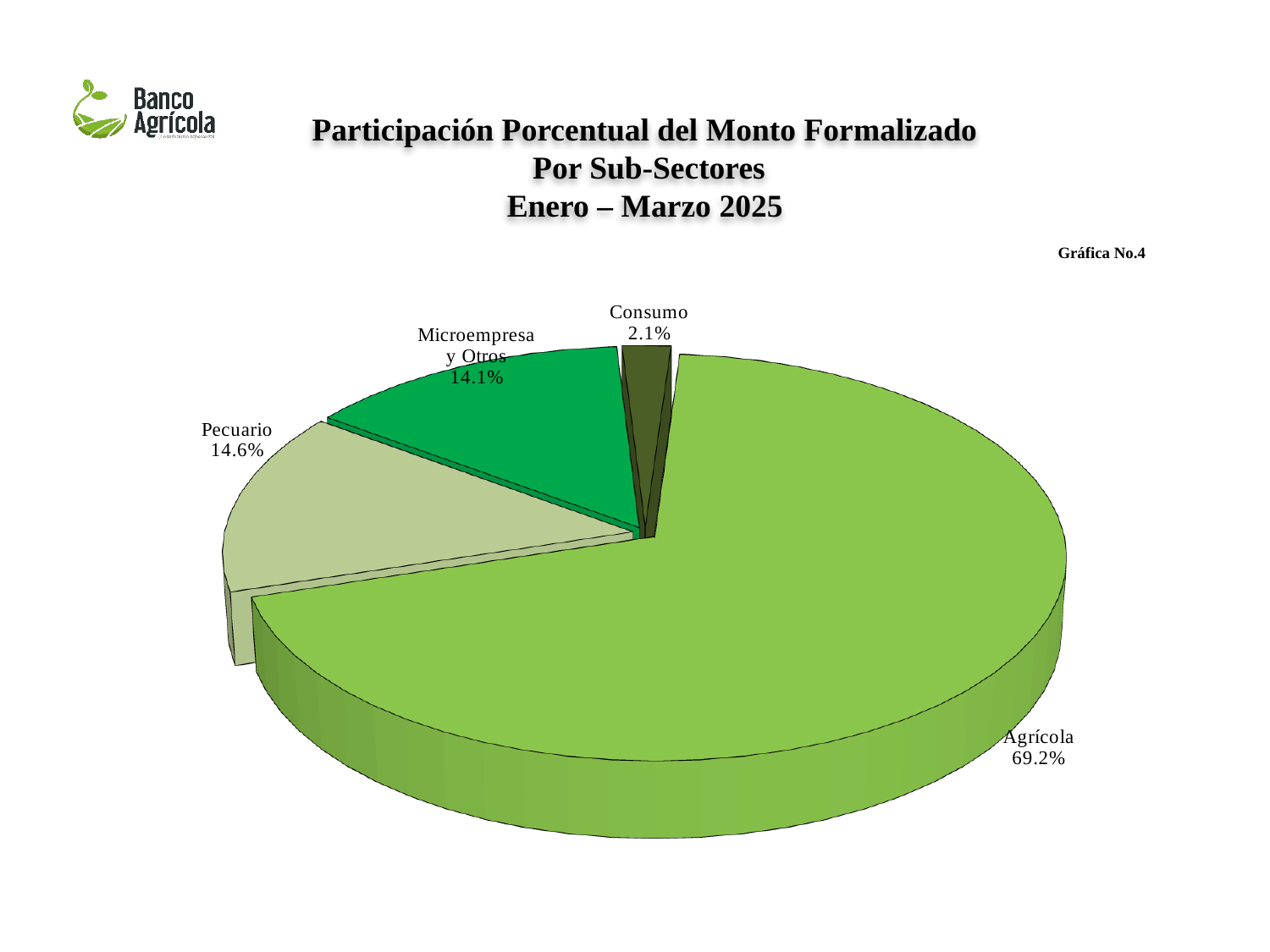
What kind of chart is shown on the slide? Pie chart What share of the pie does Consumo hold? 2.1% What is the difference in percentage points between the Pecuario and Microempresa y Otros shares? 0.5 How many sub-sectors (slices) are shown in the pie chart? 4 What share of the pie does Microempresa y Otros hold? 14.1% What share of the pie does Pecuario hold? 14.6% What period does the chart title say the data covers? Enero – Marzo 2025 What share of the pie does Agrícola hold? 69.2% Which has a larger share, Pecuario or Consumo? Pecuario Which sub-sector has the smallest share of the pie? Consumo Which sub-sector has the largest share of the pie? Agrícola What is the difference in percentage points between the Agrícola and Pecuario shares? 54.6